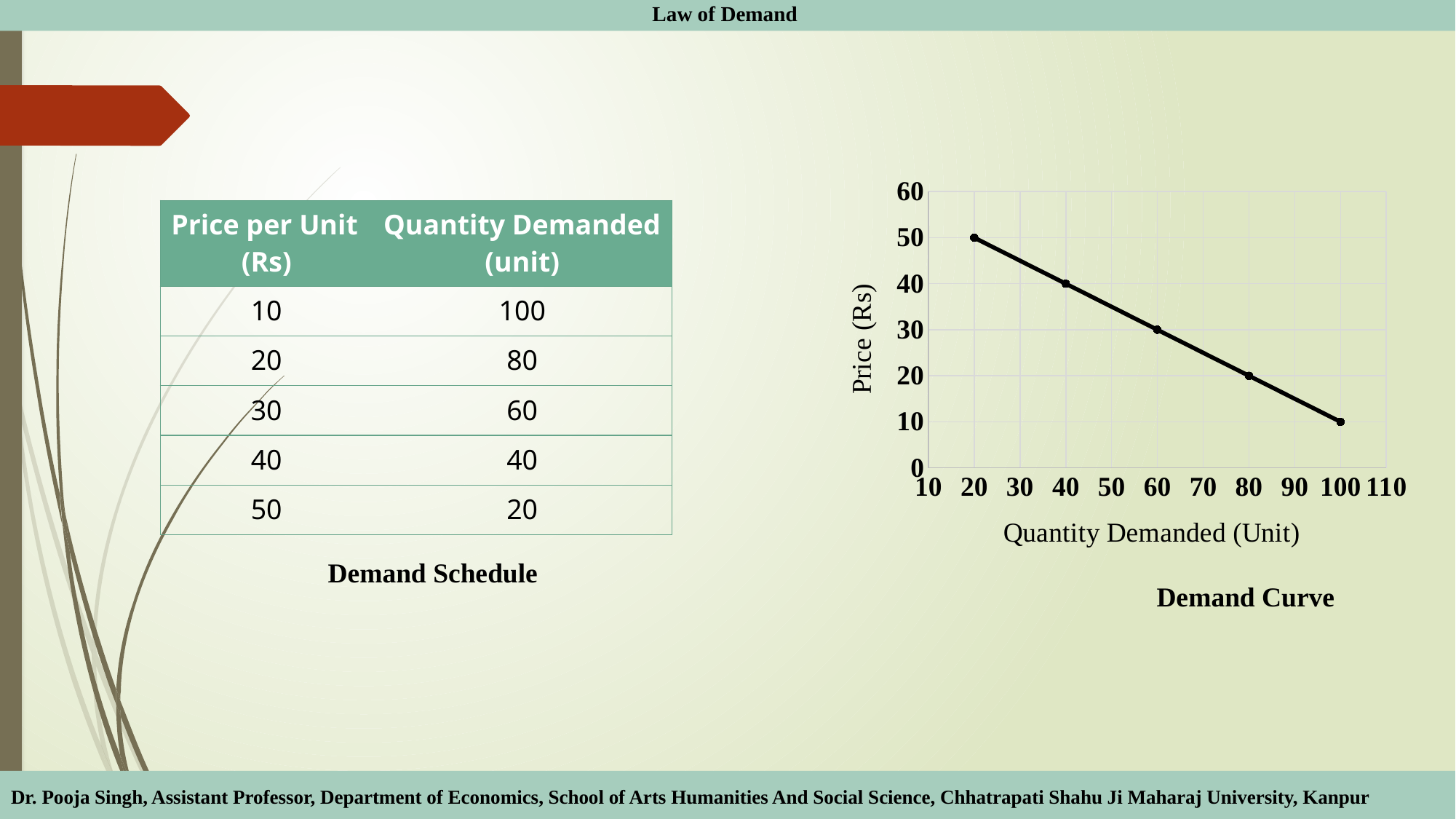
On the Demand Curve, what is the difference in price between a quantity demanded of 20 and a quantity demanded of 80? 30 On the Demand Curve, what is the price when the quantity demanded is 20 units? 50 On the Demand Curve, what is the price when the quantity demanded is 100 units? 10 What is the label of the y axis on the Demand Curve? Price (Rs) On the Demand Curve, at which quantity demanded is the price highest? 20 On the Demand Curve, what is the price when the quantity demanded is 60 units? 30 On the Demand Curve, which has the higher price: a quantity demanded of 40 or a quantity demanded of 80? 40 Does the price on the Demand Curve rise or fall as quantity demanded increases along the x axis? fall On the Demand Curve, at which quantity demanded is the price lowest? 100 What kind of chart is the Demand Curve? line chart How many data points are plotted on the Demand Curve? 5 On the Demand Curve, what quantity is demanded at a price of 40? 40